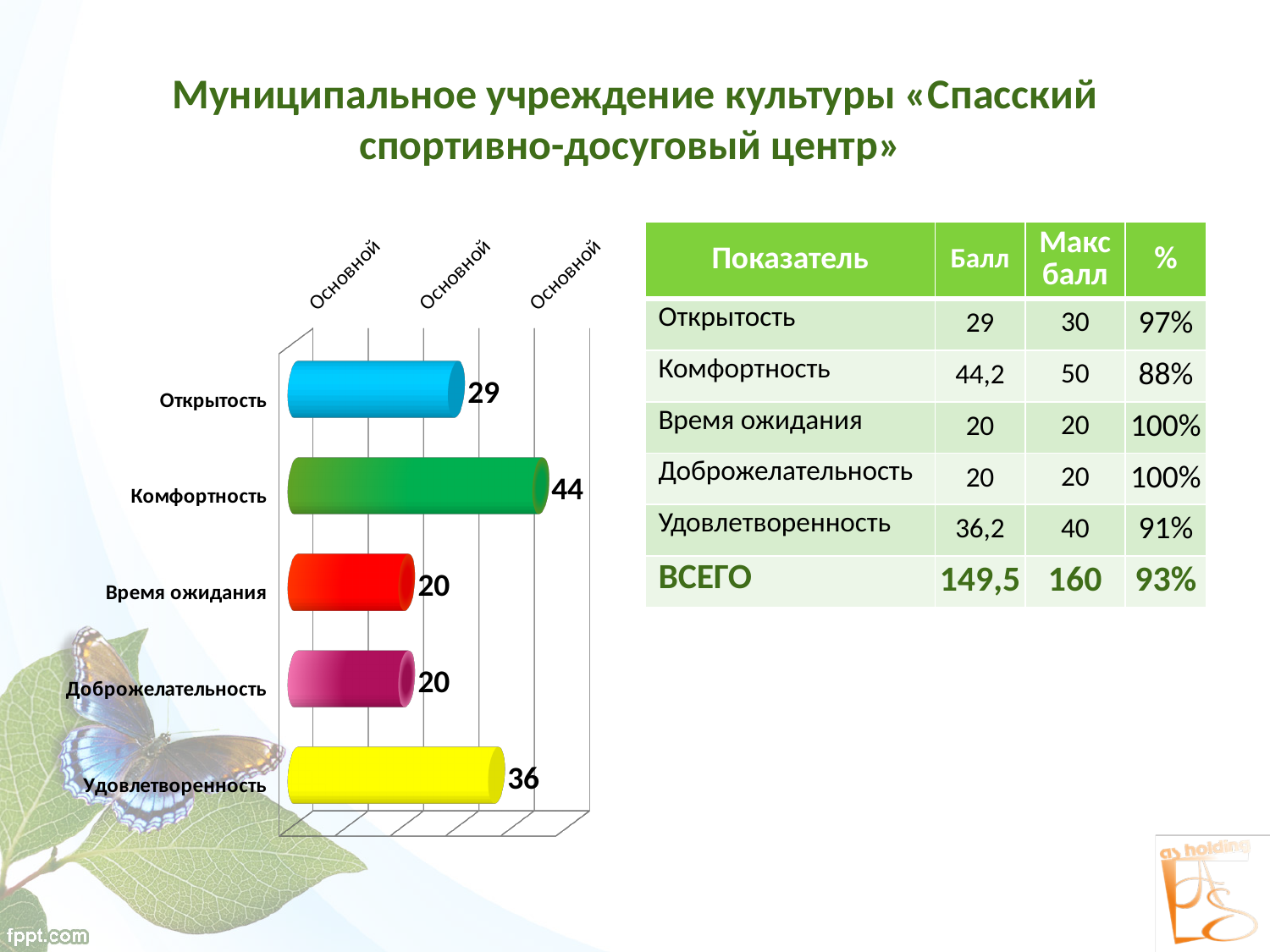
What is the value for Время ожидания in the bar chart? 20 What is the difference between the values for Удовлетворенность and Доброжелательность in the bar chart? 16 Which category has the highest value in the bar chart? Комфортность What is the value for Открытость in the bar chart? 29 What kind of chart is shown on the slide? Bar chart Which two categories share the lowest value in the bar chart? Время ожидания and Доброжелательность How many categories are shown in the bar chart? 5 What colour is the bar for Удовлетворенность in the bar chart? Yellow What is the difference between the values for Комфортность and Открытость in the bar chart? 15 Which is larger in the bar chart, the value for Открытость or the value for Удовлетворенность? Удовлетворенность What is the value for Комфортность in the bar chart? 44 What is the value for Удовлетворенность in the bar chart? 36